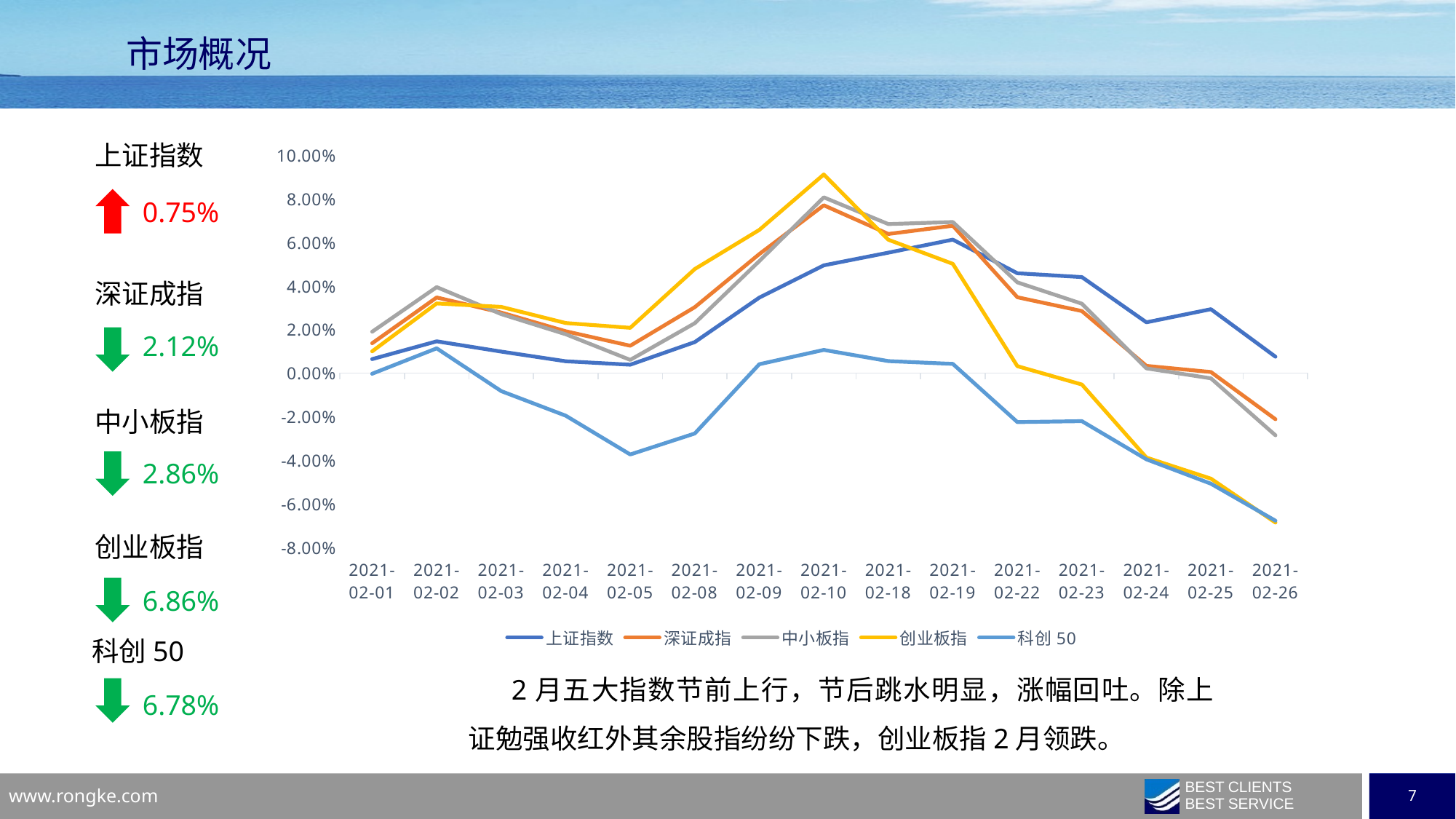
Is the value for 创业板指 on 2021-02-10 greater or less than 8.00%? greater How many dates are shown along the x axis of the chart? 15 Is the value for 科创 50 on 2021-02-05 greater or less than -2.00%? less Is the value for 深证成指 on 2021-02-26 greater or less than 0.00%? less How many series does the chart legend list? 5 What is the first entry listed in the chart legend? 上证指数 On 2021-02-26, which is larger: the value for 上证指数 or the value for 科创 50? 上证指数 Which series has the highest value on 2021-02-10? 创业板指 What kind of chart is shown on the slide? line chart Which series has the lowest value on 2021-02-05? 科创 50 Does the 创业板指 line rise or fall from 2021-02-10 to 2021-02-26? fall Which series has the highest value on 2021-02-26? 上证指数